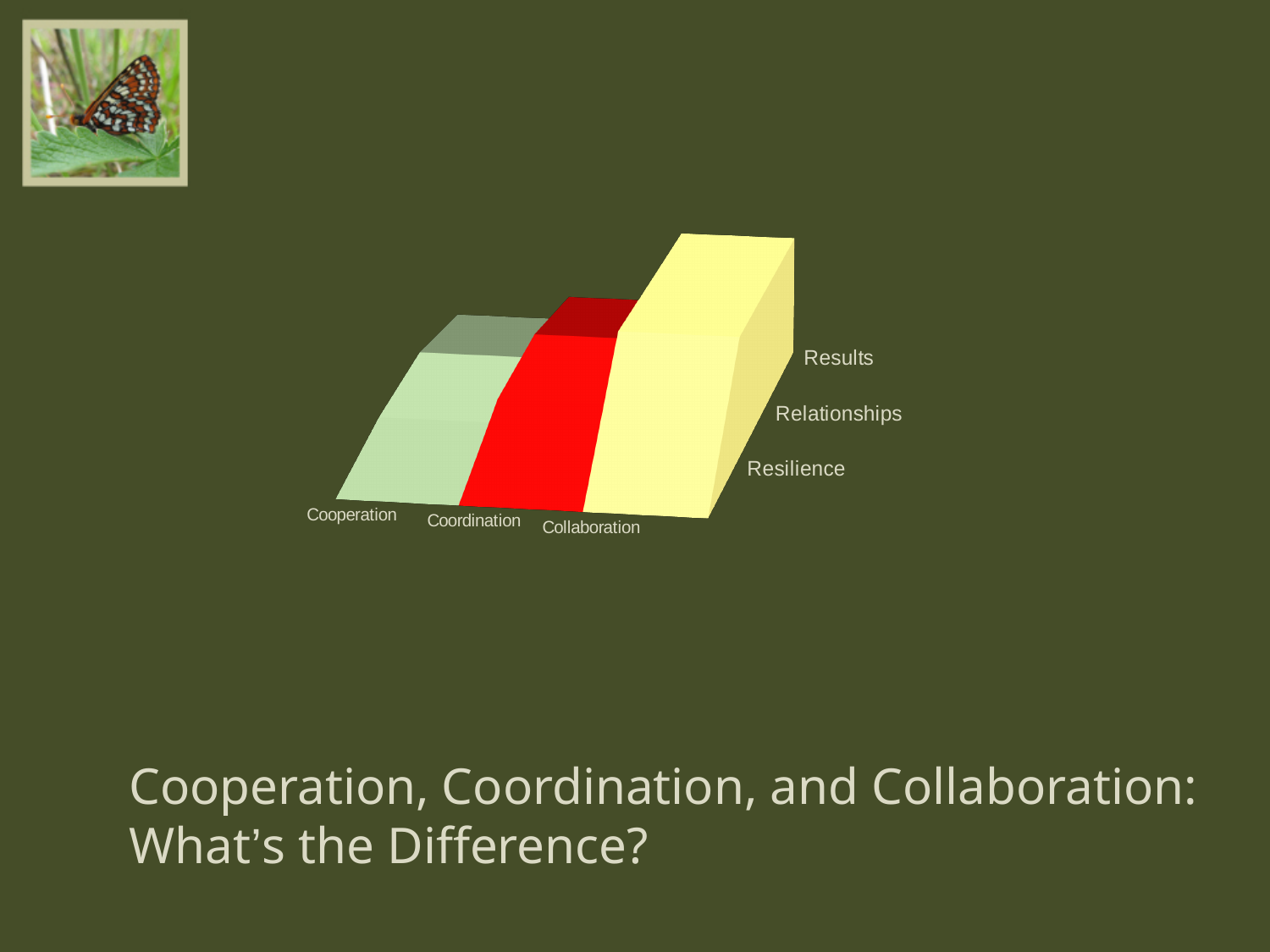
What are the three categories labelled along the x axis of the chart? Cooperation, Coordination, Collaboration What are the three series labelled along the depth axis of the chart? Results, Relationships, Resilience What colour is the Collaboration section of the chart? yellow Which category has the lowest values in the chart? Cooperation Which is larger in the chart, the value for Collaboration or the value for Cooperation? Collaboration How many categories are shown along the x axis of the chart? 3 How many series are labelled along the depth axis of the chart? 3 Which category has the highest values in the chart? Collaboration Which is larger in the chart, the value for Coordination or the value for Cooperation? Coordination Do the values rise or fall moving from Cooperation to Collaboration along the x axis? rise